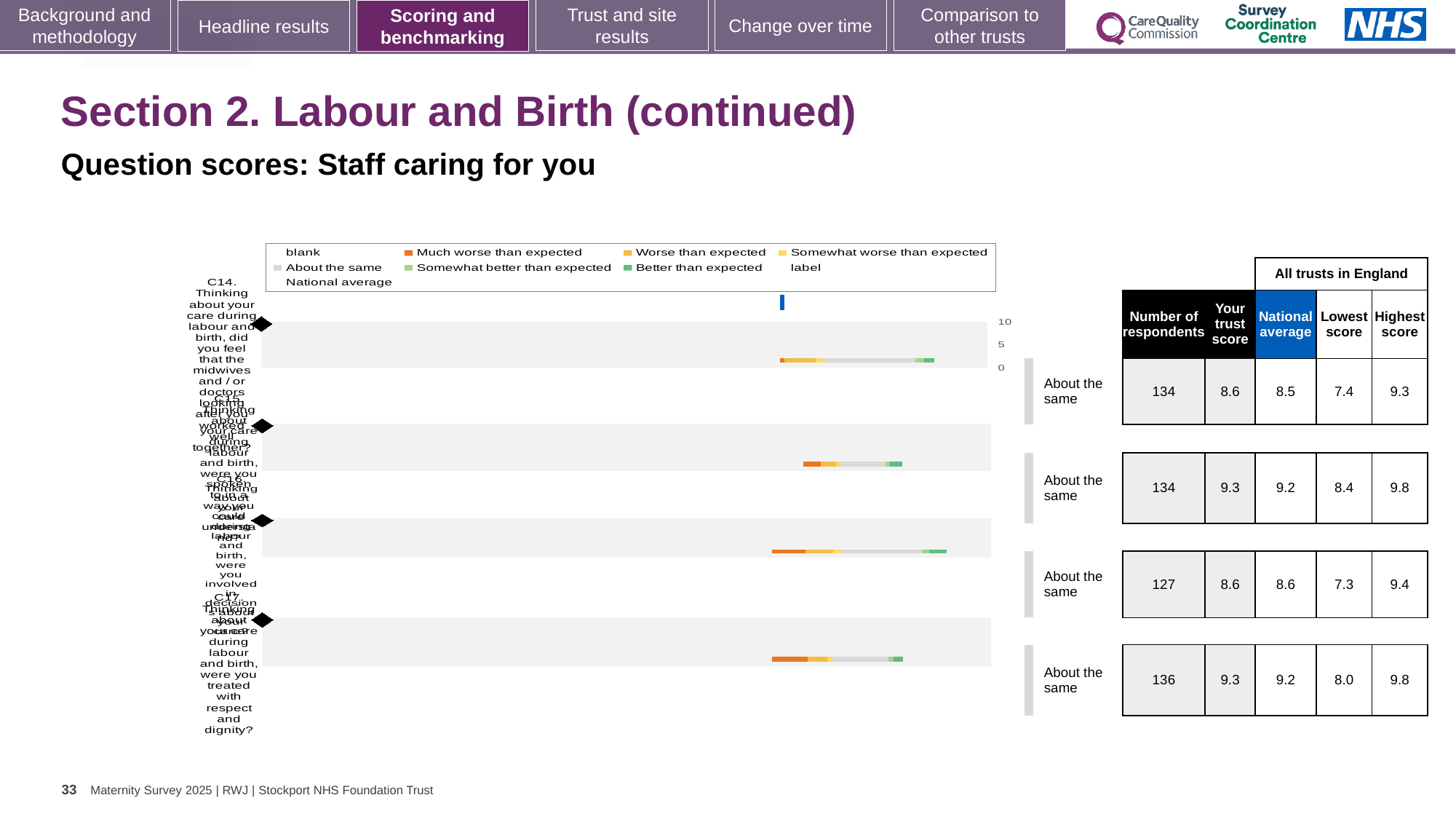
How many question categories (rows of bars) does the chart show? 4 In the table beside the chart, what is the 'Your trust score' in the first row (C14)? 8.6 In the table beside the chart, what is the difference between the 'Your trust score' and the 'National average' in the second row (C15)? 0.1 In the table beside the chart, what is the 'Highest score' in the second row (C15)? 9.8 What kind of chart is shown on the slide? bar chart In the table beside the chart, which row has the lowest 'Lowest score'? third row (C16), 7.3 In the table beside the chart, what is the 'Lowest score' in the fourth row (C17)? 8.0 Which legend entry is shown in orange? Much worse than expected How many entries does the chart's legend list? 9 What is the highest tick value shown on the chart's axis? 10 In the table beside the chart, what is the 'Number of respondents' in the third row (C16)? 127